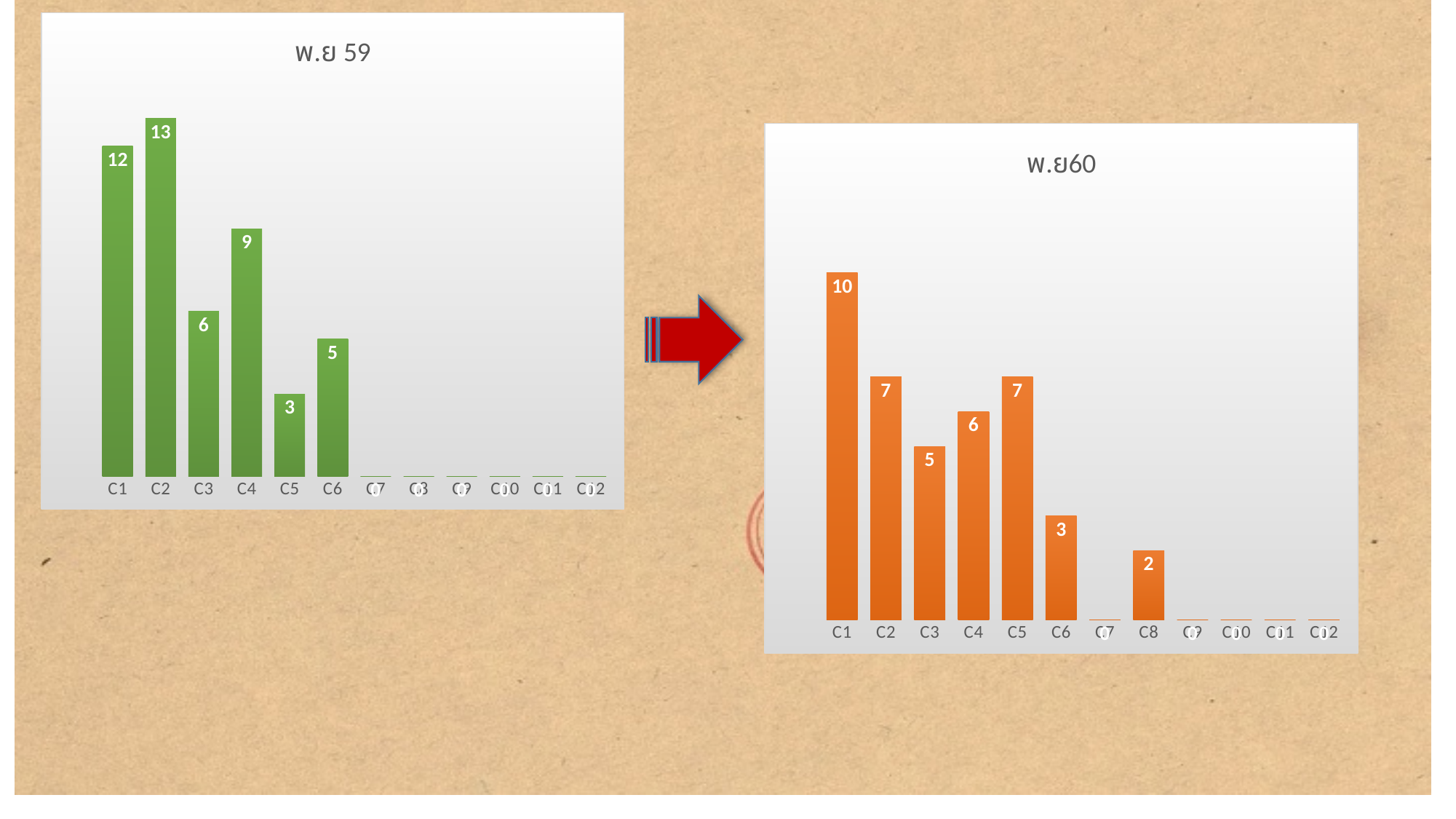
In the left chart titled พ.ย 59, what is the value for C2? 13 In the right chart titled พ.ย60, what is the difference between the values for C1 and C3? 5 What colour are the bars in the left chart titled พ.ย 59? Green In the right chart titled พ.ย60, which is larger, the value for C4 or the value for C6? C4 What kind of chart is the right chart titled พ.ย60? Bar chart In the right chart titled พ.ย60, what is the value for C1? 10 In the right chart titled พ.ย60, which category has the highest value? C1 In the right chart titled พ.ย60, what is the value for C8? 2 In the left chart titled พ.ย 59, which category has the highest value? C2 In the left chart titled พ.ย 59, what is the difference between the values for C1 and C5? 9 In the left chart titled พ.ย 59, what is the value for C4? 9 How many categories are shown on the x axis of the left chart titled พ.ย 59? 12